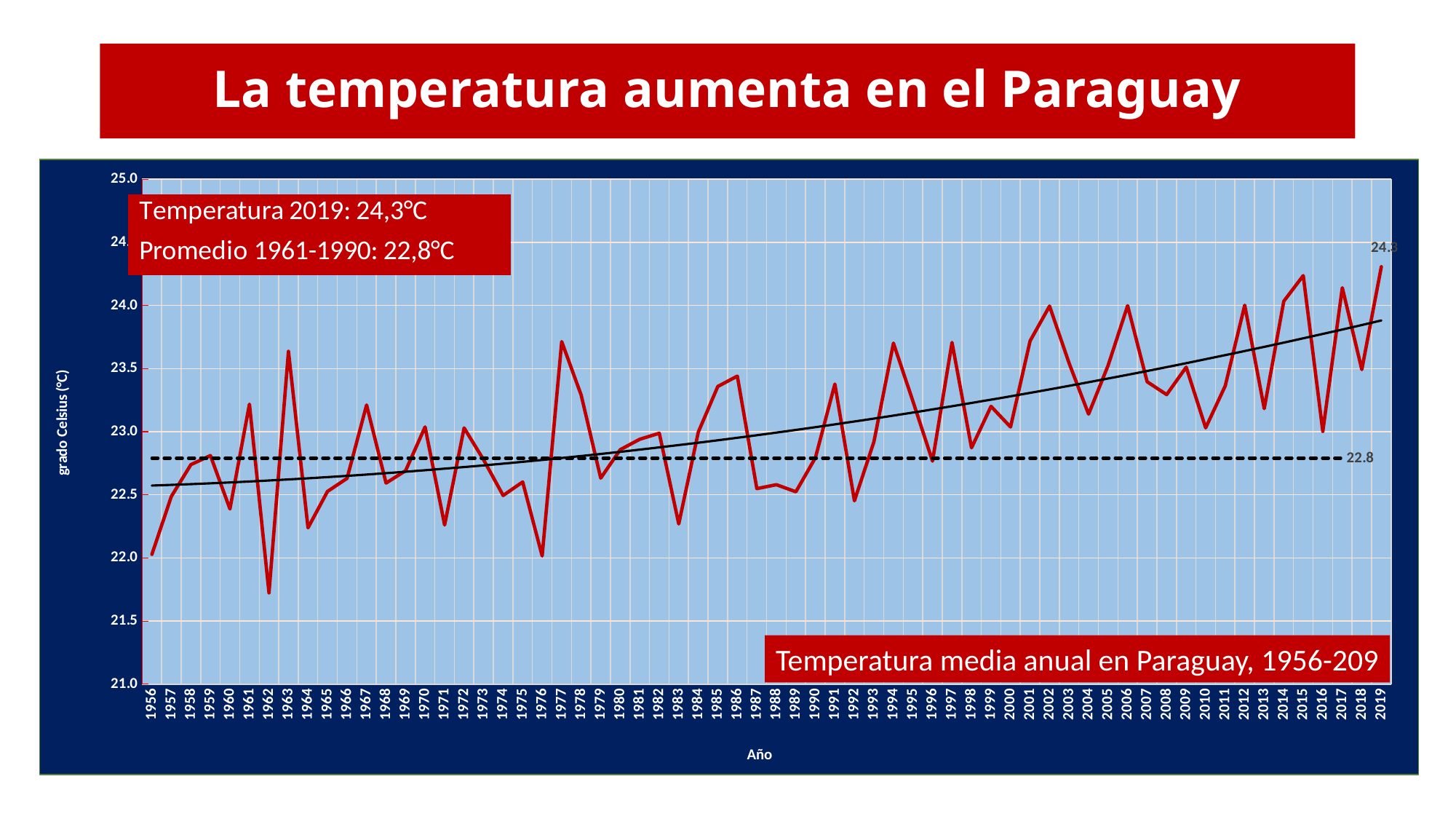
Is the value for 1977 greater or less than 23.5? greater Which year has the lowest temperature on the chart? 1962 What is the temperature value labelled for 2019? 24.3 What value is labelled on the dashed horizontal line? 22.8 How many years are plotted on the x axis? 64 What type of chart is shown on the slide? line chart What is the difference between the 2019 value (24.3) and the dashed line value (22.8)? 1.5 Do the temperatures generally rise or fall from 1956 to 2019? rise Which year has the higher temperature, 1956 or 2019? 2019 Is the value for 1962 greater or less than 22.0? less Is the value for 1983 greater or less than 22.5? less What is the title of the x axis? Año